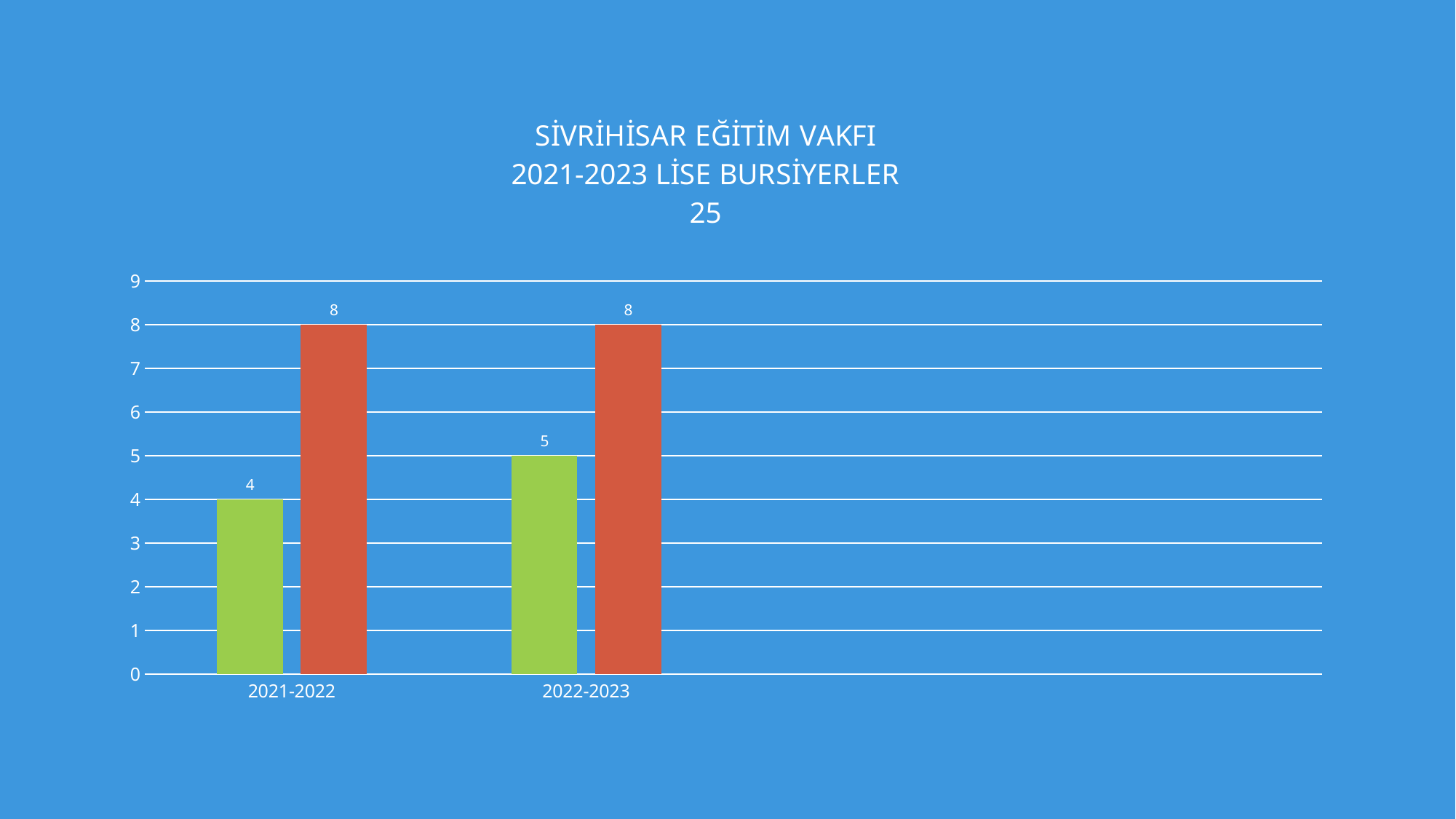
What is the value of the red bar for 2022-2023? 8 What is the difference between the red bar and the green bar for 2021-2022? 4 What is the value of the green bar for 2022-2023? 5 What is the difference between the red bar and the green bar for 2022-2023? 3 Which category has the higher green bar, 2021-2022 or 2022-2023? 2022-2023 How many categories are shown on the x axis? 2 Do the green bars rise or fall from 2021-2022 to 2022-2023? Rise By how much does the green bar increase from 2021-2022 to 2022-2023? 1 What is the value of the green bar for 2021-2022? 4 What is the value of the red bar for 2021-2022? 8 What kind of chart is shown on the slide? Bar chart What is the highest value shown on the vertical axis? 9